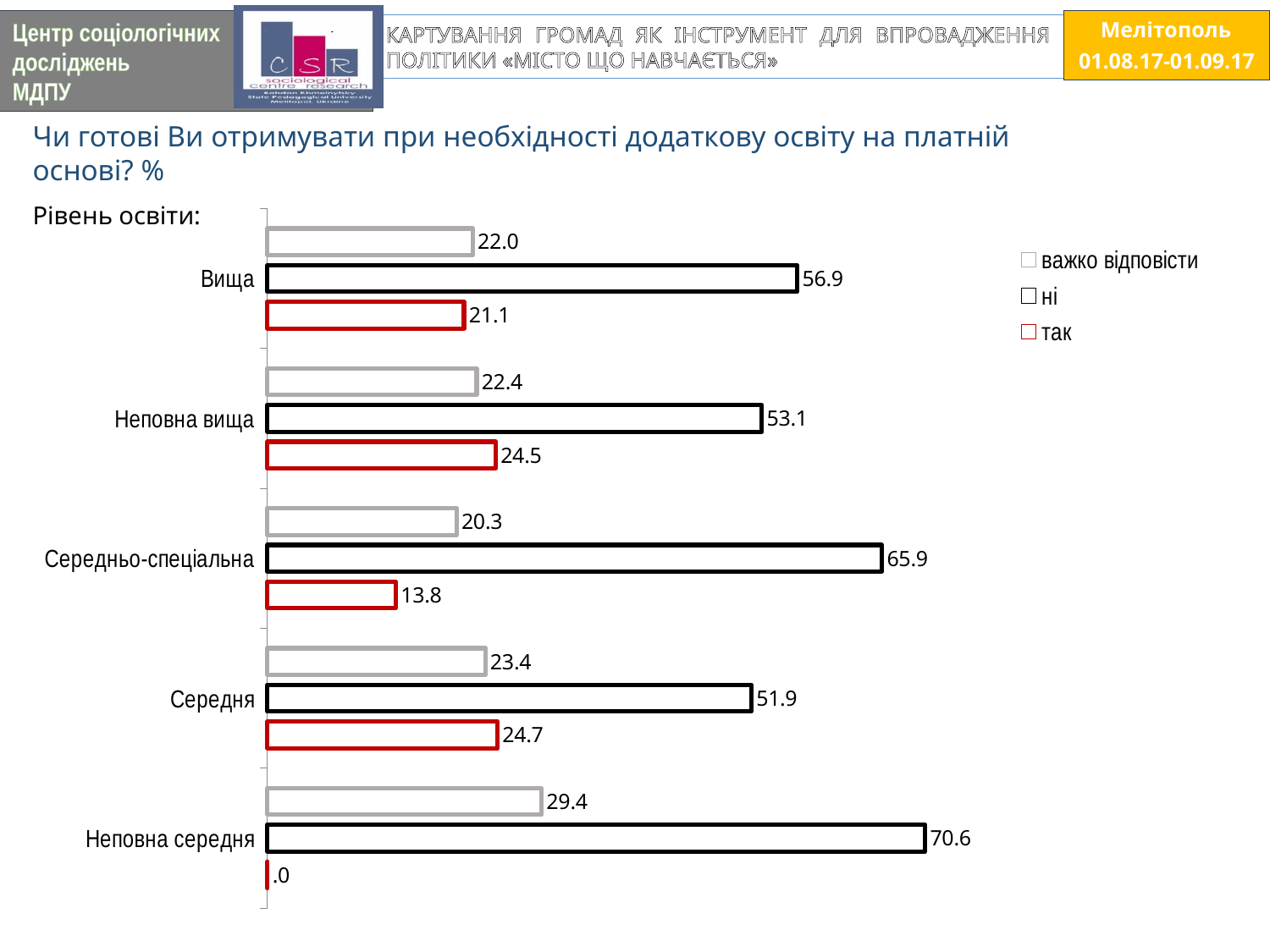
What is the value for "так" in the "Вища" category? 21.1 What is the value for "ні" in the "Середньо-спеціальна" category? 65.9 Which education level has the lowest value for "так"? Неповна середня What kind of chart is shown on the slide? Bar chart What is the difference between the "ні" values for "Неповна середня" and "Середня"? 18.7 How many education level categories are shown in the chart? 5 What is the total of the three values for the "Вища" category? 100.0 Which is larger: the "так" value for "Середня" or for "Неповна вища"? Середня What is the value for "важко відповісти" in the "Неповна середня" category? 29.4 Which series is drawn in red in the chart? так How many series does the legend list? 3 Which education level has the highest value for "ні"? Неповна середня